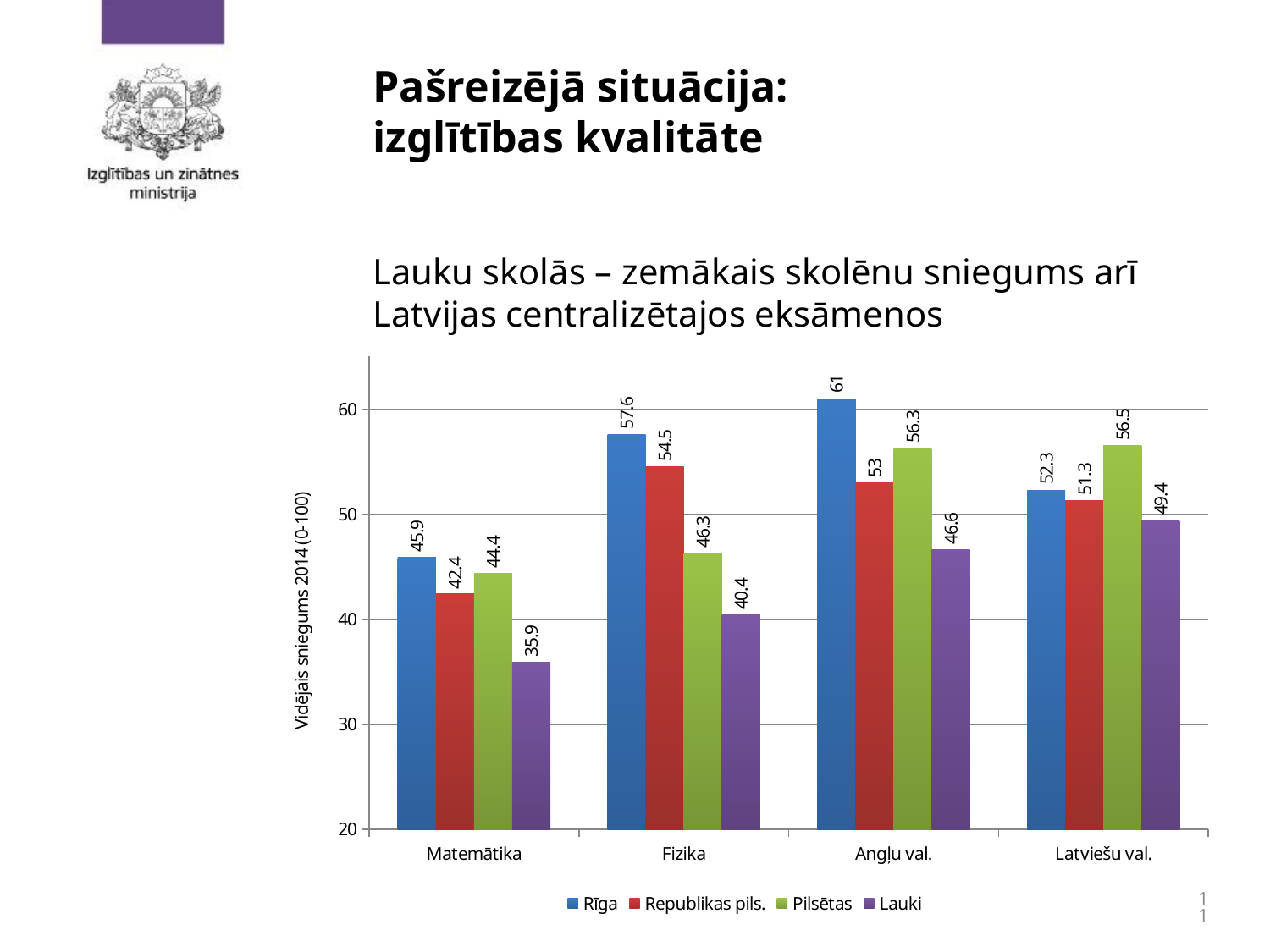
What is the value for Republikas pils. in Latviešu val.? 51.3 What is the difference between Rīga and Lauki in Angļu val.? 14.4 What is the value for Rīga in Matemātika? 45.9 Which is larger in Latviešu val.: Pilsētas or Rīga? Pilsētas What is the label of the vertical axis? Vidējais sniegums 2014 (0-100) How many subject categories are shown on the x axis? 4 What kind of chart is shown on the slide? Bar chart What is the value for Lauki in Fizika? 40.4 How many series does the legend list? 4 What is the value for Pilsētas in Angļu val.? 56.3 Which subject has the highest value for Rīga? Angļu val. Which subject has the lowest value for Lauki? Matemātika